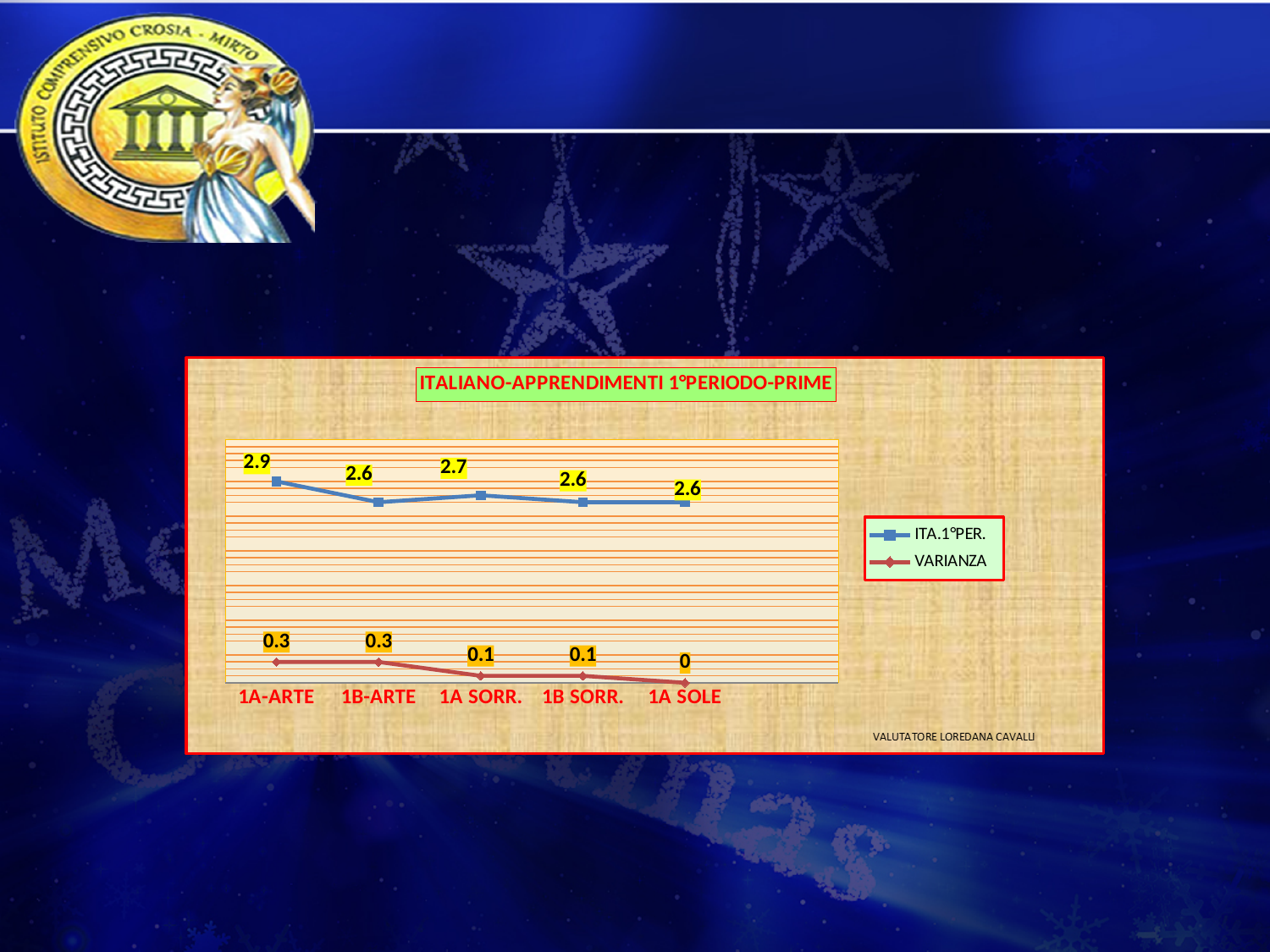
What kind of chart is shown on the slide? Line chart Does the VARIANZA series rise or fall from 1A-ARTE to 1A SOLE? Fall Which category has the highest ITA.1°PER. value? 1A-ARTE What is the difference between the ITA.1°PER. values for 1A-ARTE and 1B-ARTE? 0.3 What is the ITA.1°PER. value for 1A SORR.? 2.7 Which is larger, the VARIANZA value for 1B-ARTE or for 1B SORR.? 1B-ARTE Which category has the lowest VARIANZA value? 1A SOLE What is the title of the chart? ITALIANO-APPRENDIMENTI 1°PERIODO-PRIME What is the ITA.1°PER. value for 1A-ARTE? 2.9 What is the VARIANZA value for 1A SOLE? 0 How many series does the legend list? 2 How many categories are shown on the x axis? 5